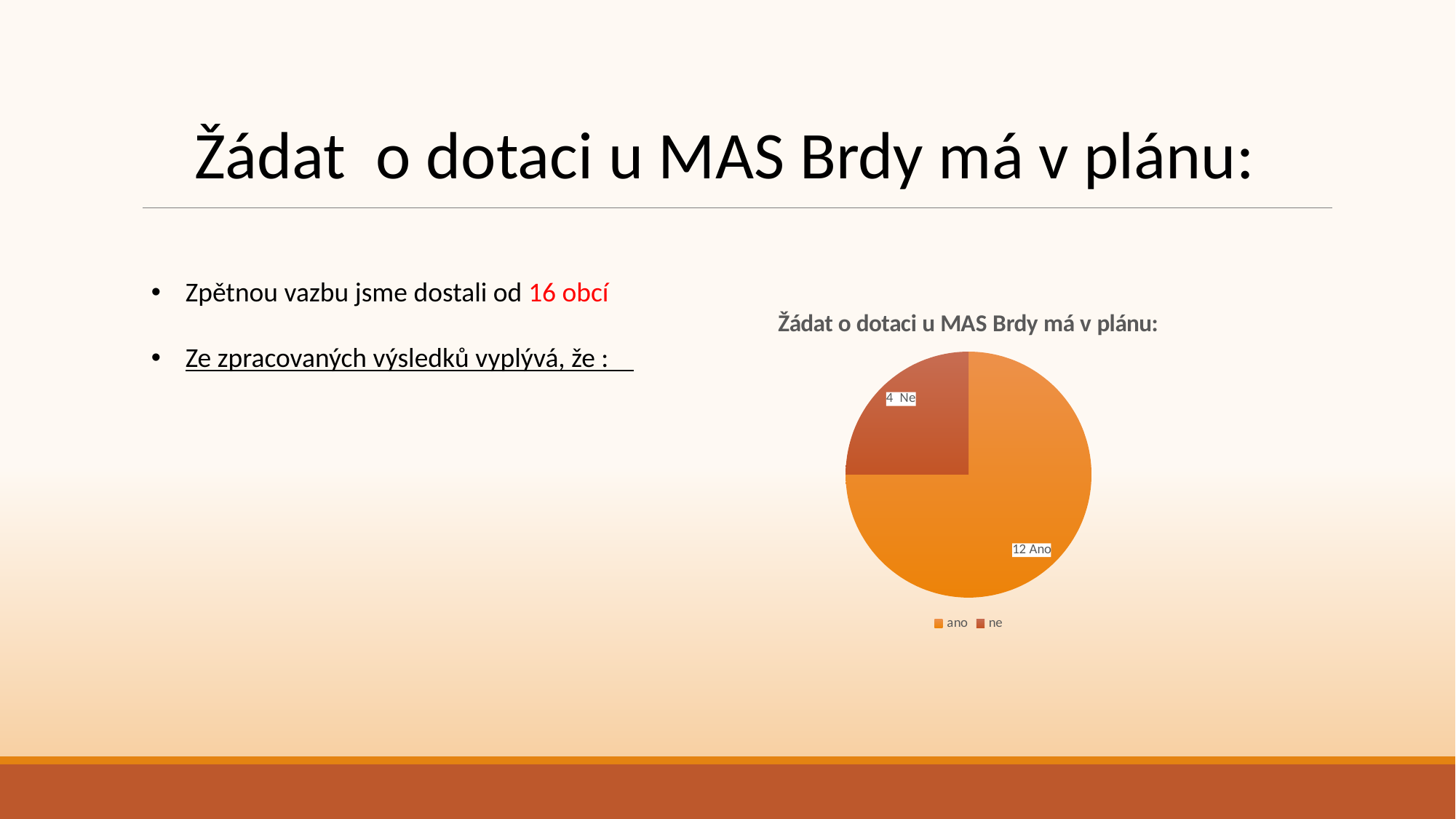
What is the total of all slices in the pie chart? 16 What share of the pie does the "Ne" slice represent? 25% What is the value for the "Ne" slice? 4 How many entries does the legend list? 2 How many slices does the pie chart have? 2 What kind of chart is shown on the slide? pie chart What is the difference between the "Ano" and "Ne" values? 8 Which is larger, "Ano" or "Ne"? Ano What is the title of the chart? Žádat o dotaci u MAS Brdy má v plánu: Which slice is the largest? Ano What is the value for the "Ano" slice? 12 Which slice is the smallest? Ne